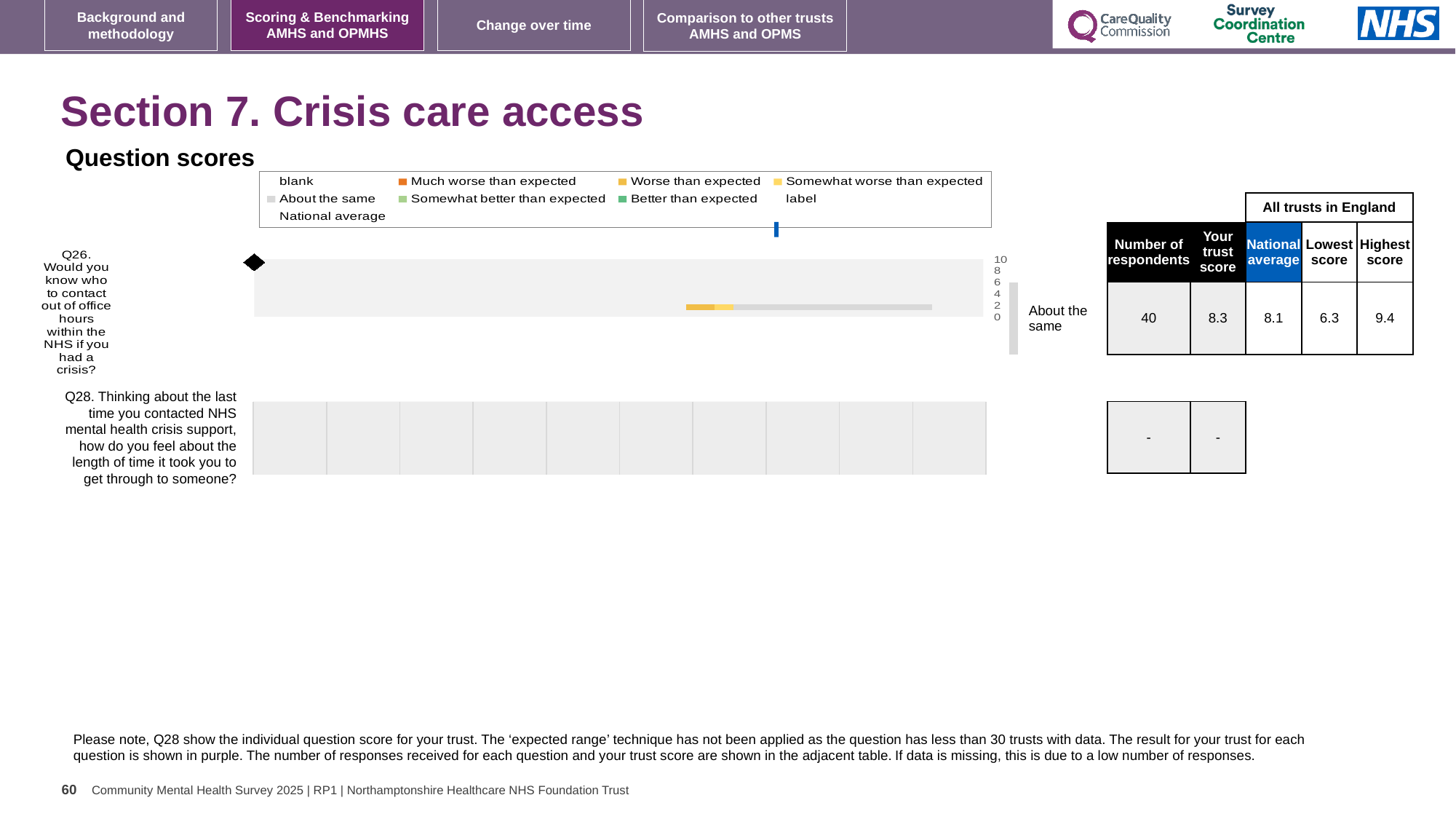
Which is larger for Q26: the trust score or the national average? Trust score What kind of chart is used to show the question scores? Bar chart What is the national average for Q26? 8.1 What is the title of the chart section above the legend? Question scores What is the trust score for Q26 shown in the table next to the chart? 8.3 What category label is shown for the trust's Q26 result relative to the expected range? About the same What is the difference between the highest and lowest scores for Q26 across all trusts in England? 3.1 How many respondents answered Q26? 40 What is the lowest score among all trusts in England for Q26? 6.3 What is the difference between the trust score and the national average for Q26? 0.2 What is the highest score among all trusts in England for Q26? 9.4 How many questions are plotted on the chart? 2